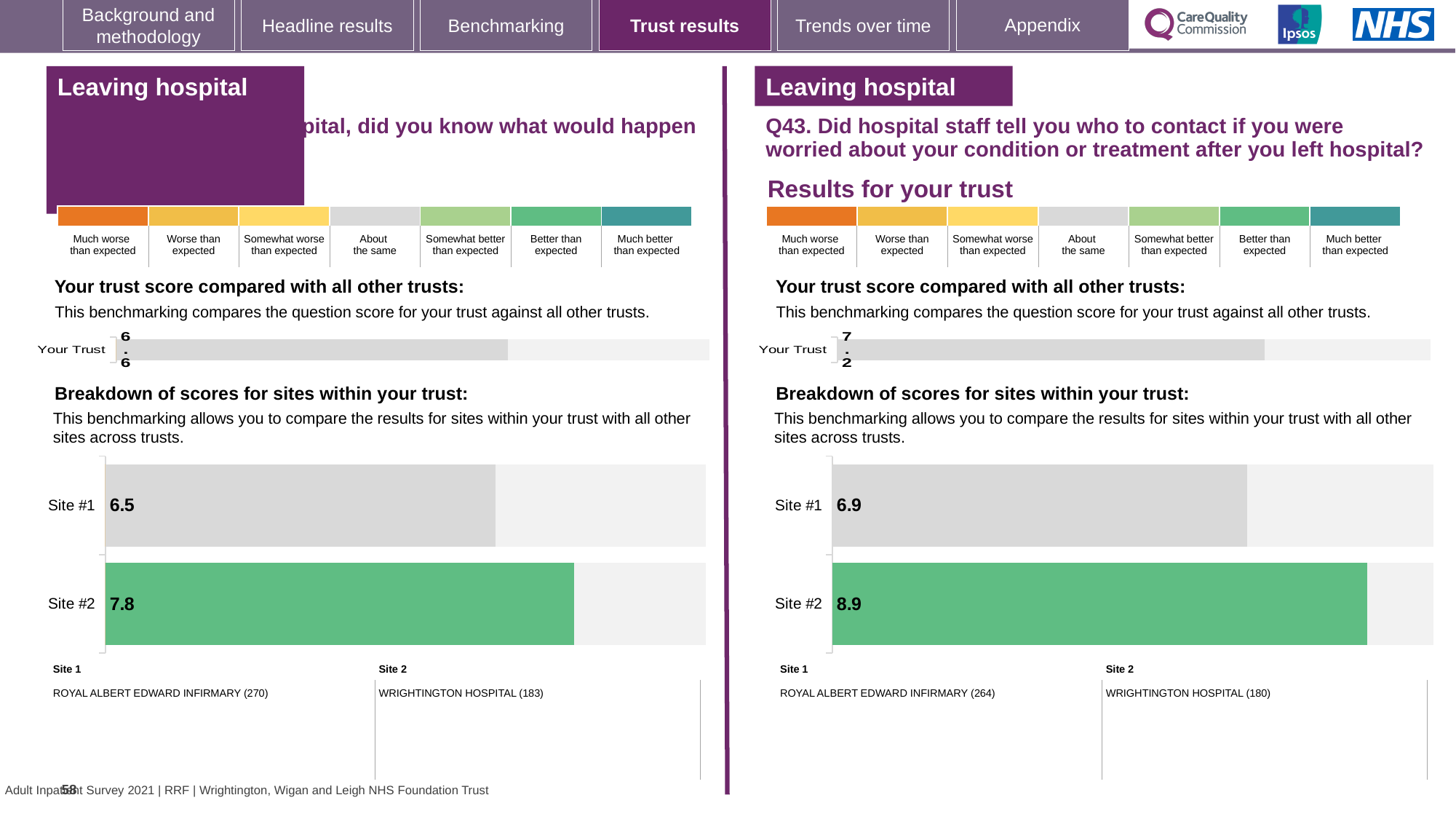
On the left-hand 'Breakdown of scores for sites within your trust' chart, what is the difference between the Site #2 and Site #1 scores? 1.3 On the Q43 'Breakdown of scores for sites within your trust' chart, which site has the higher score? Site #2 On the Q43 'Your trust score compared with all other trusts' chart, what is the score for Your Trust? 7.2 What type of chart is used for the 'Breakdown of scores for sites within your trust' on the Q43 side? Bar chart On the left-hand 'Breakdown of scores for sites within your trust' chart, what is the score for Site #2? 7.8 On the Q43 'Breakdown of scores for sites within your trust' chart, what is the score for Site #2? 8.9 How many sites are shown on the Q43 'Breakdown of scores for sites within your trust' chart? 2 On the Q43 'Breakdown of scores for sites within your trust' chart, what is the difference between the Site #2 and Site #1 scores? 2.0 On the left-hand 'Breakdown of scores for sites within your trust' chart, which site has the lower score? Site #1 On the left-hand 'Breakdown of scores for sites within your trust' chart, what is the score for Site #1? 6.5 On the Q43 'Breakdown of scores for sites within your trust' chart, what is the score for Site #1? 6.9 On the left-hand 'Your trust score compared with all other trusts' chart, what is the score for Your Trust? 6.6